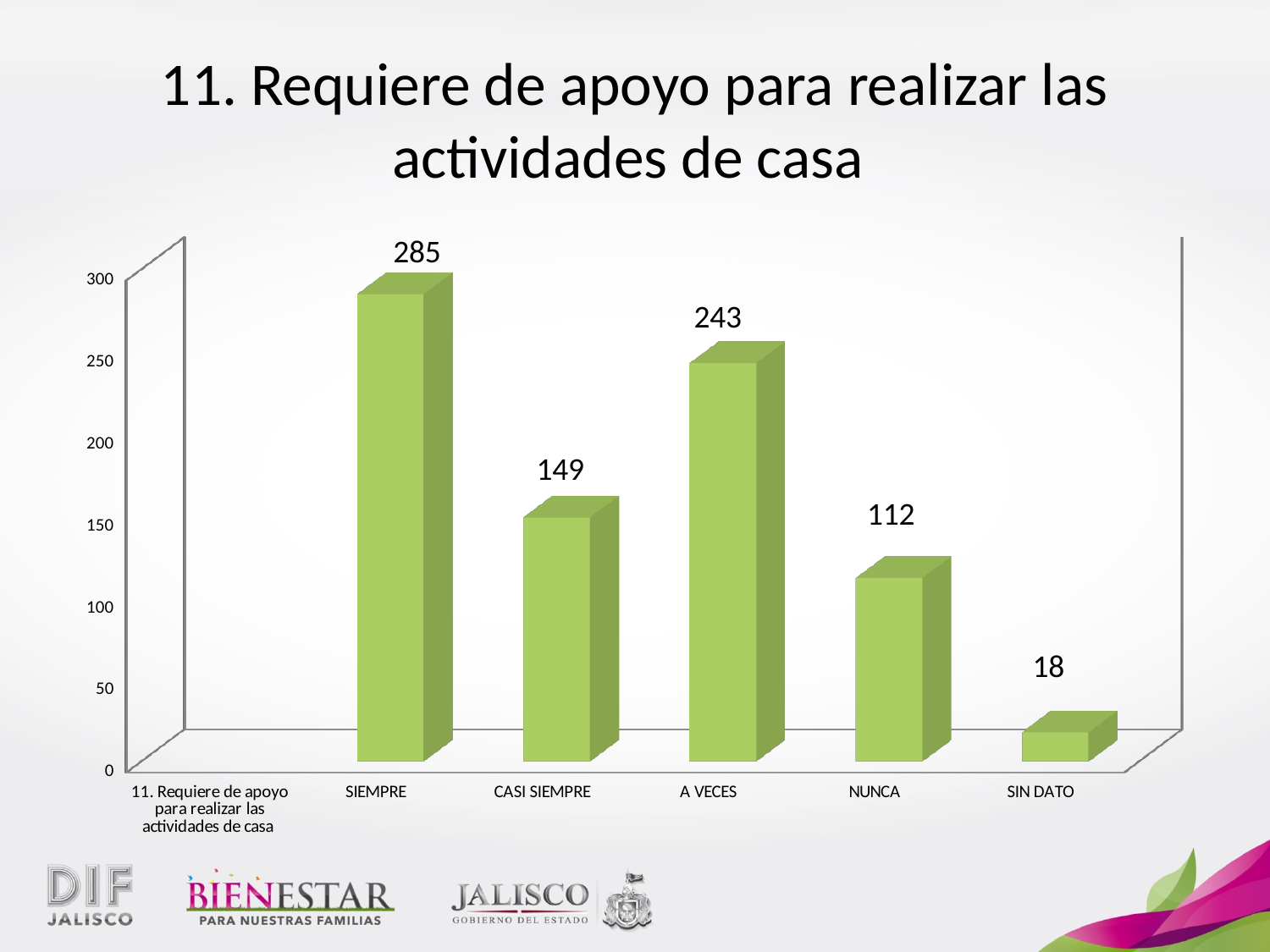
What is the value for NUNCA? 112 Which category has the lowest value? SIN DATO Which category has the highest value? SIEMPRE How many bars are plotted in the chart? 5 Which is larger, the value for CASI SIEMPRE or the value for NUNCA? CASI SIEMPRE What is the value for CASI SIEMPRE? 149 What is the title of the slide's chart? 11. Requiere de apoyo para realizar las actividades de casa What is the difference between the values for SIEMPRE and A VECES? 42 What kind of chart is shown on the slide? Bar chart What is the value for SIEMPRE? 285 What is the value for SIN DATO? 18 What is the value for A VECES? 243